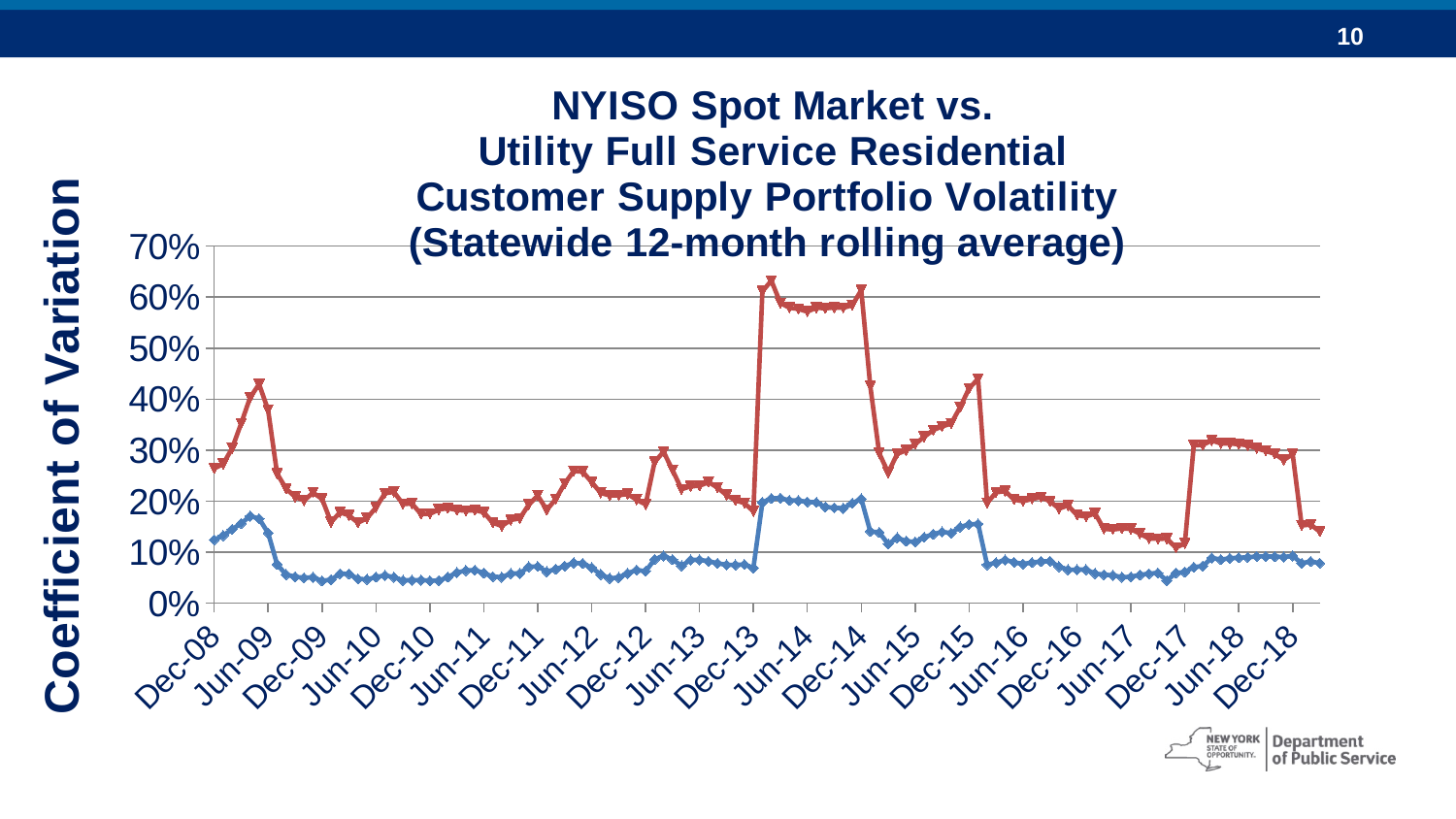
How many data series (lines) are plotted on the chart? 2 Is the value of the blue line at Jun-14 greater or less than 30%? less Is the value of the blue line at Jun-18 greater or less than 10%? less Does the red line rise or fall between Dec-15 and Dec-17? Fall What type of chart is shown on the slide? Line chart Is the value of the red line at Jun-14 greater or less than 50%? greater Which line, red or blue, has the higher value at Dec-15? Red What is the highest value shown on the y axis? 70% How many date labels are shown along the x axis? 21 What is the y-axis title of the chart? Coefficient of Variation